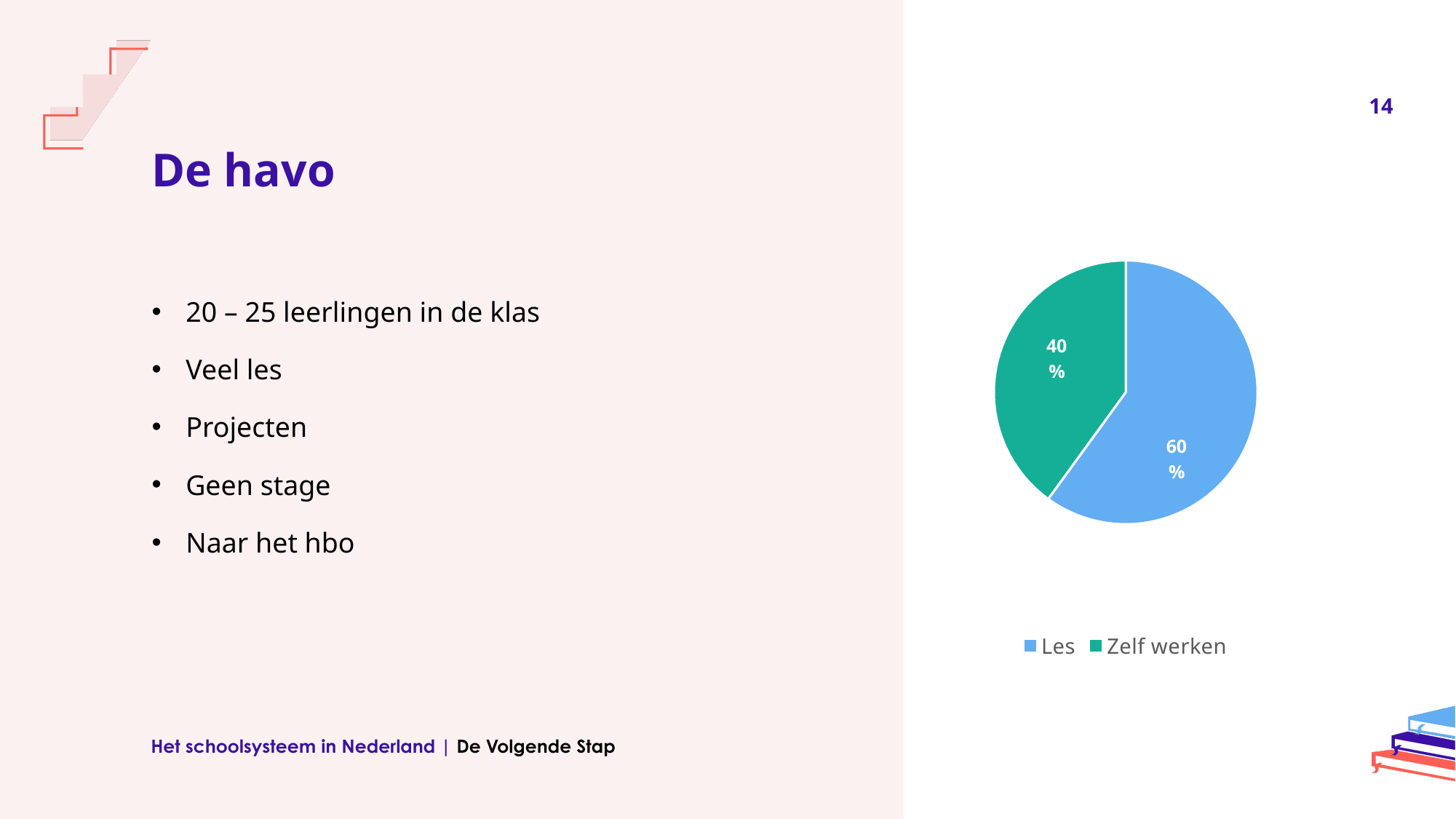
Which slice of the pie is the largest? Les How many slices does the pie chart have? 2 What is the difference in percentage points between the "Les" slice and the "Zelf werken" slice? 20 What colour is the "Les" slice? blue What colour is the "Zelf werken" slice? green Which is larger, the "Les" slice or the "Zelf werken" slice? Les What share of the pie does "Zelf werken" take? 40% Which slice of the pie is the smallest? Zelf werken What kind of chart is shown on the slide? pie chart What share of the pie does "Les" take? 60% How many entries does the legend list? 2